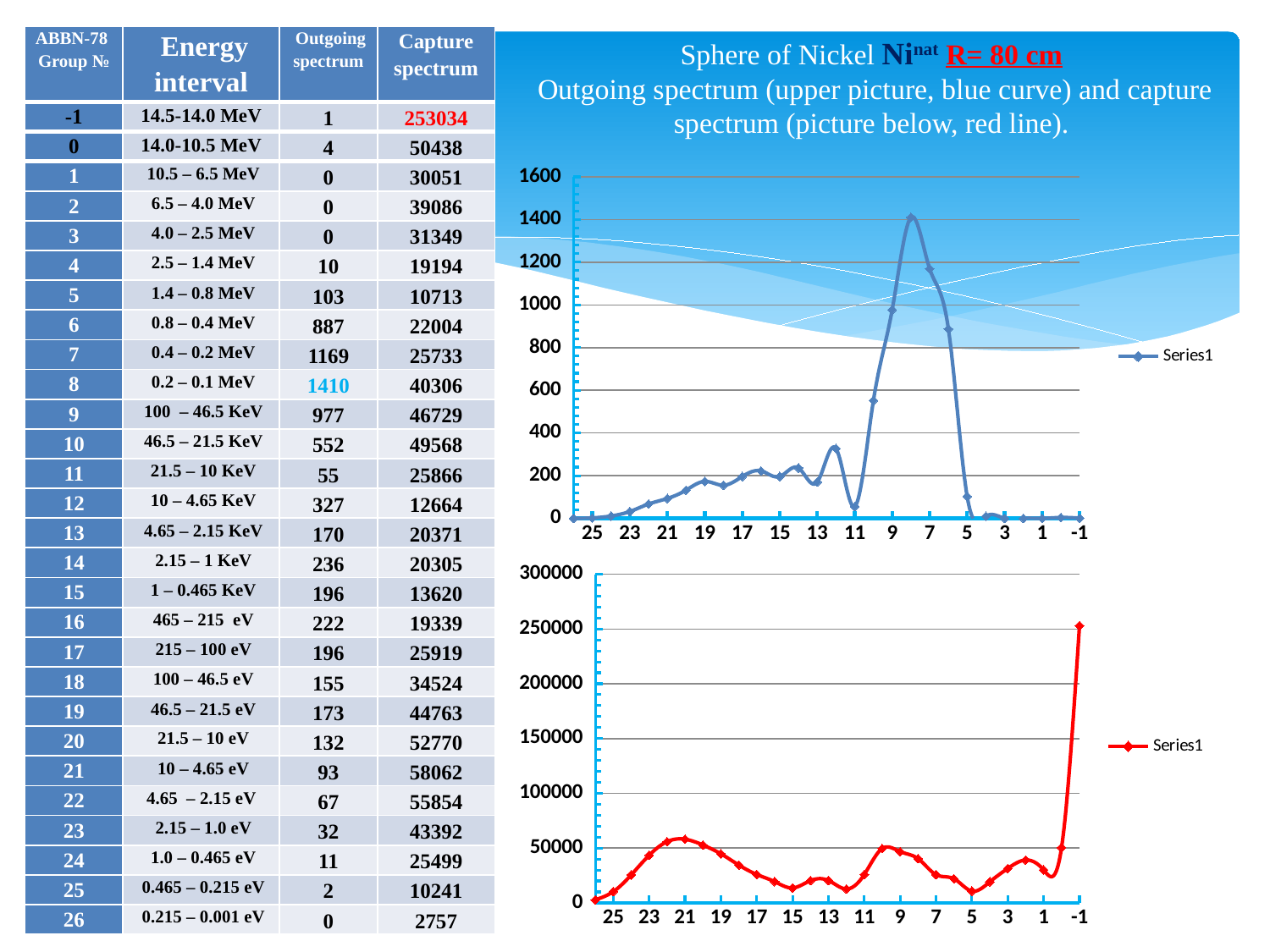
In the lower chart, which x-axis category has the highest value? -1 What is the highest tick value shown on the y axis of the upper chart? 1600 In the upper chart, is the value at x = 9 greater or less than 800? greater In the lower chart, is the value at x = 5 greater or less than 50000? less In the upper chart, is the value at x = 11 greater or less than 200? less In the lower chart, which is larger: the value at x = 21 or the value at x = 13? x = 21 What kind of chart is the upper chart on the slide? line chart What kind of chart is the lower chart on the slide? line chart In the upper chart, which is larger: the value at x = 9 or the value at x = 13? x = 9 How many series does the legend of the upper chart list? 1 What is the name of the series shown in the legend of the lower chart? Series1